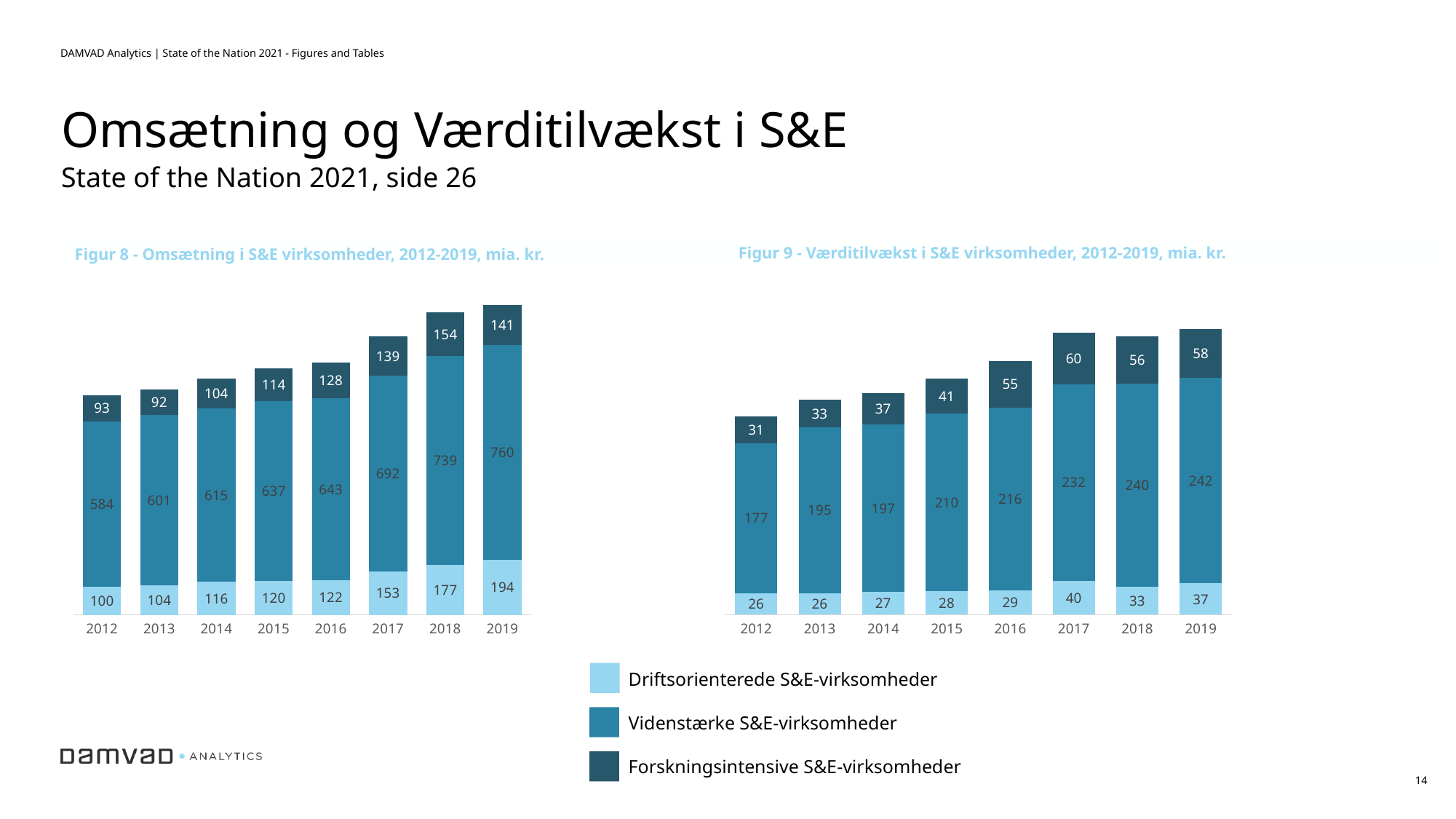
How many years are shown on the x axis of Figur 8 (Omsætning i S&E virksomheder)? 8 In Figur 9 (Værditilvækst i S&E virksomheder), what is the value for Forskningsintensive S&E-virksomheder in 2017? 60 In Figur 8 (Omsætning i S&E virksomheder), what is the difference between the Vidensstærke values for 2019 and 2012? 176 In Figur 8 (Omsætning i S&E virksomheder), what is the value for Vidensstærke S&E-virksomheder in 2019? 760 In Figur 8 (Omsætning i S&E virksomheder), what is the value for Driftsorienterede S&E-virksomheder in 2012? 100 In Figur 8 (Omsætning i S&E virksomheder), what is the total of the stacked bar for 2012? 777 What kind of chart is Figur 9 (Værditilvækst i S&E virksomheder)? Stacked bar chart In Figur 9 (Værditilvækst i S&E virksomheder), is the Driftsorienterede value larger in 2017 or in 2018? 2017 In Figur 8 (Omsætning i S&E virksomheder), which year has the lowest value for Forskningsintensive S&E-virksomheder? 2013 In Figur 9 (Værditilvækst i S&E virksomheder), which year has the highest value for Vidensstærke S&E-virksomheder? 2019 In Figur 9 (Værditilvækst i S&E virksomheder), what is the total of the stacked bar for 2019? 337 How many series does the legend list for the charts on the slide? 3